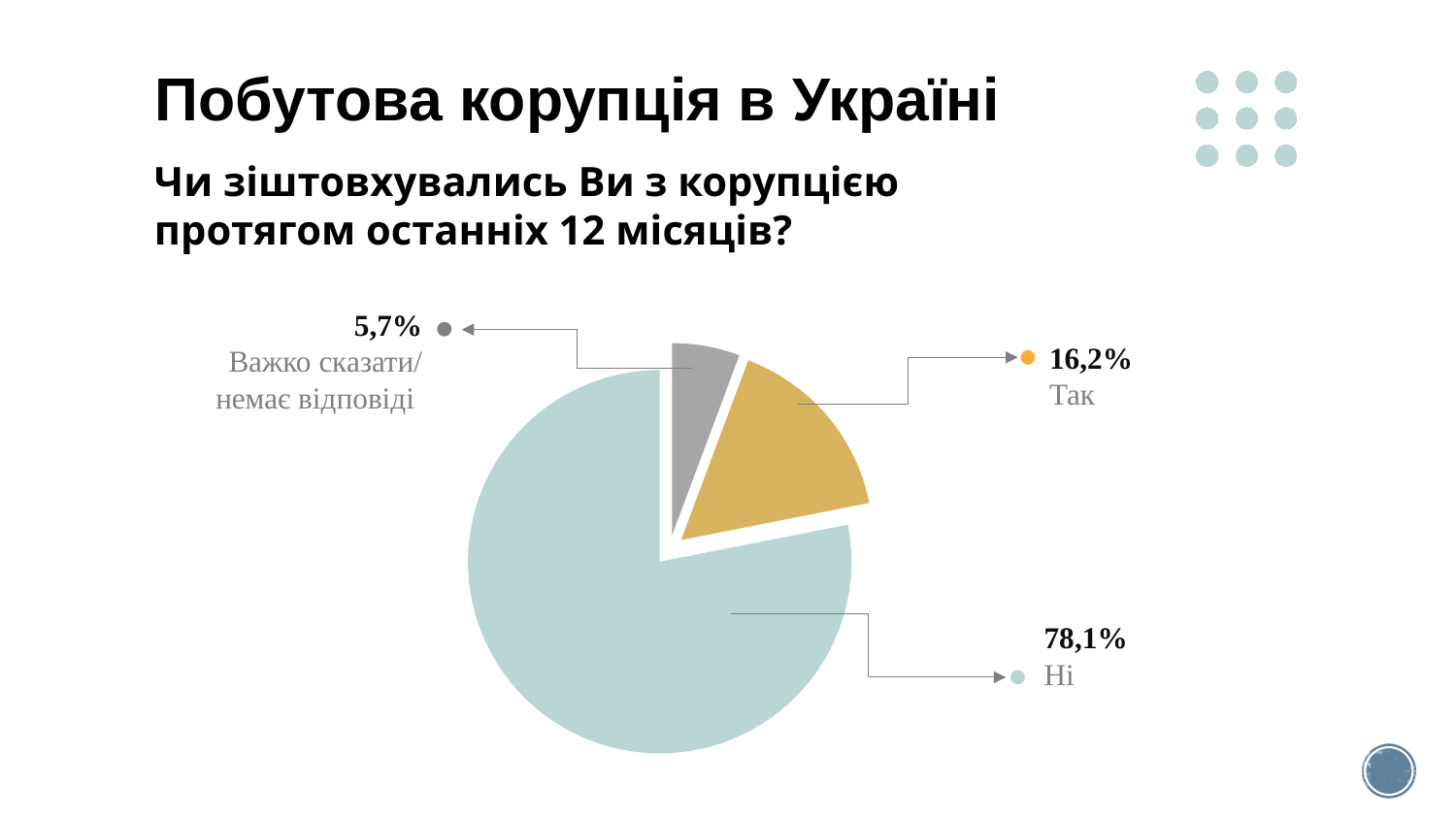
What share of respondents answered "Ні" (No)? 78,1% Which answer has the smallest share of the pie? Важко сказати/немає відповіді What share of respondents answered "Так" (Yes)? 16,2% What is the difference in percentage points between the "Ні" and "Так" shares? 61,9 What share of respondents answered "Важко сказати/немає відповіді"? 5,7% How many slices does the pie chart have? 3 Which is larger: the share for "Так" or the share for "Важко сказати/немає відповіді"? Так What is the difference in percentage points between the "Так" share and the "Важко сказати/немає відповіді" share? 10,5 What question does the chart answer, according to the slide subtitle? Чи зіштовхувались Ви з корупцією протягом останніх 12 місяців? What kind of chart is shown on the slide? Pie chart What colour is the slice for "Так"? Yellow/gold Which answer has the largest share of the pie? Ні